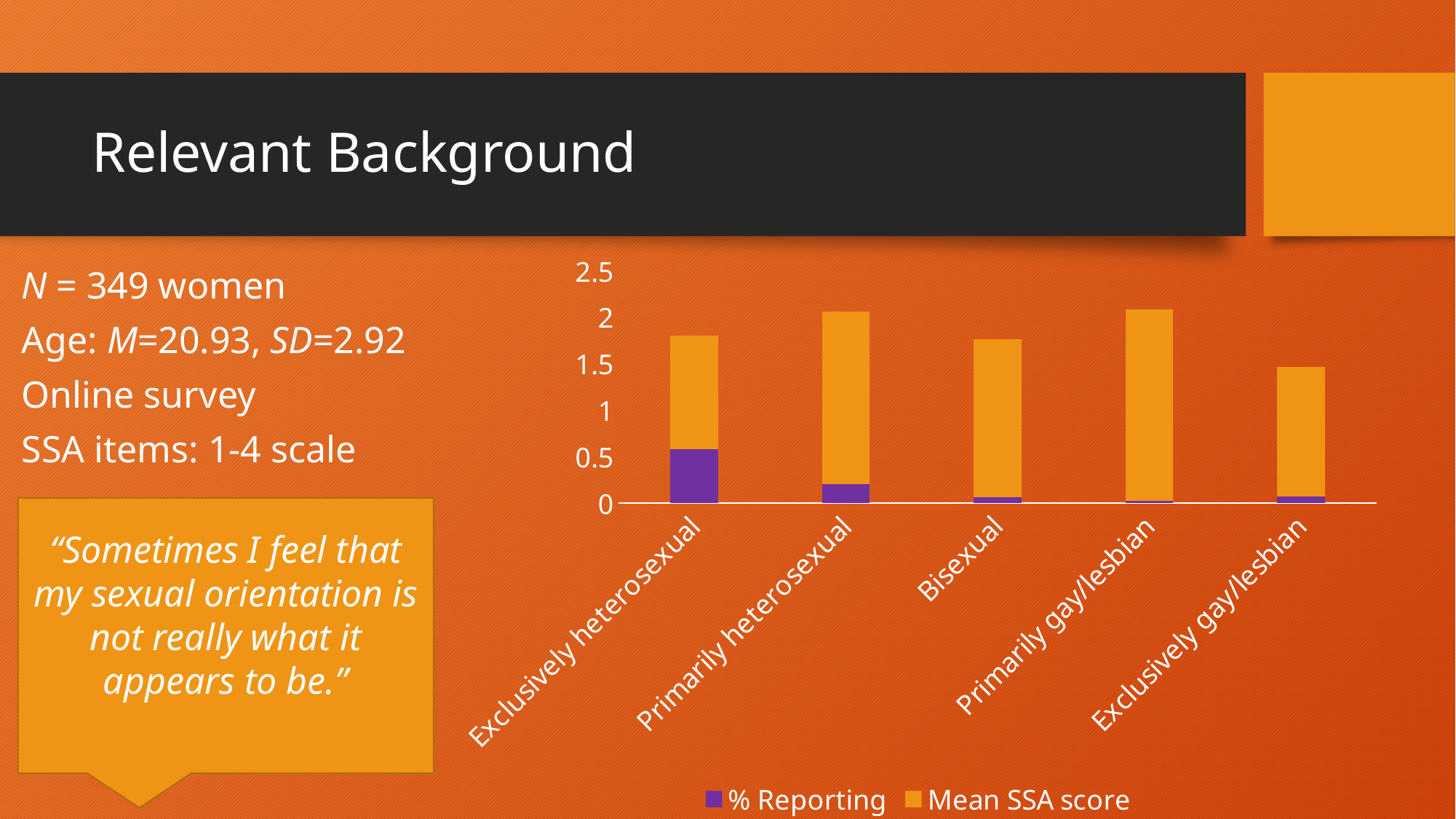
What kind of chart is shown on the slide? Stacked bar chart How many series does the chart's legend list? 2 Is the total stacked bar for Exclusively gay/lesbian greater or less than 2? less Is the total stacked bar for Exclusively heterosexual greater or less than 1.5? greater Is the total stacked bar for Bisexual greater or less than 2? less Which has the larger % Reporting value, Exclusively heterosexual or Primarily heterosexual? Exclusively heterosexual Which category has the highest % Reporting value? Exclusively heterosexual Which has the larger total stacked bar, Exclusively heterosexual or Exclusively gay/lesbian? Exclusively heterosexual What colour represents the % Reporting series in the chart? Purple How many categories are shown along the x axis of the chart? 5 Which category has the lowest total stacked bar height? Exclusively gay/lesbian